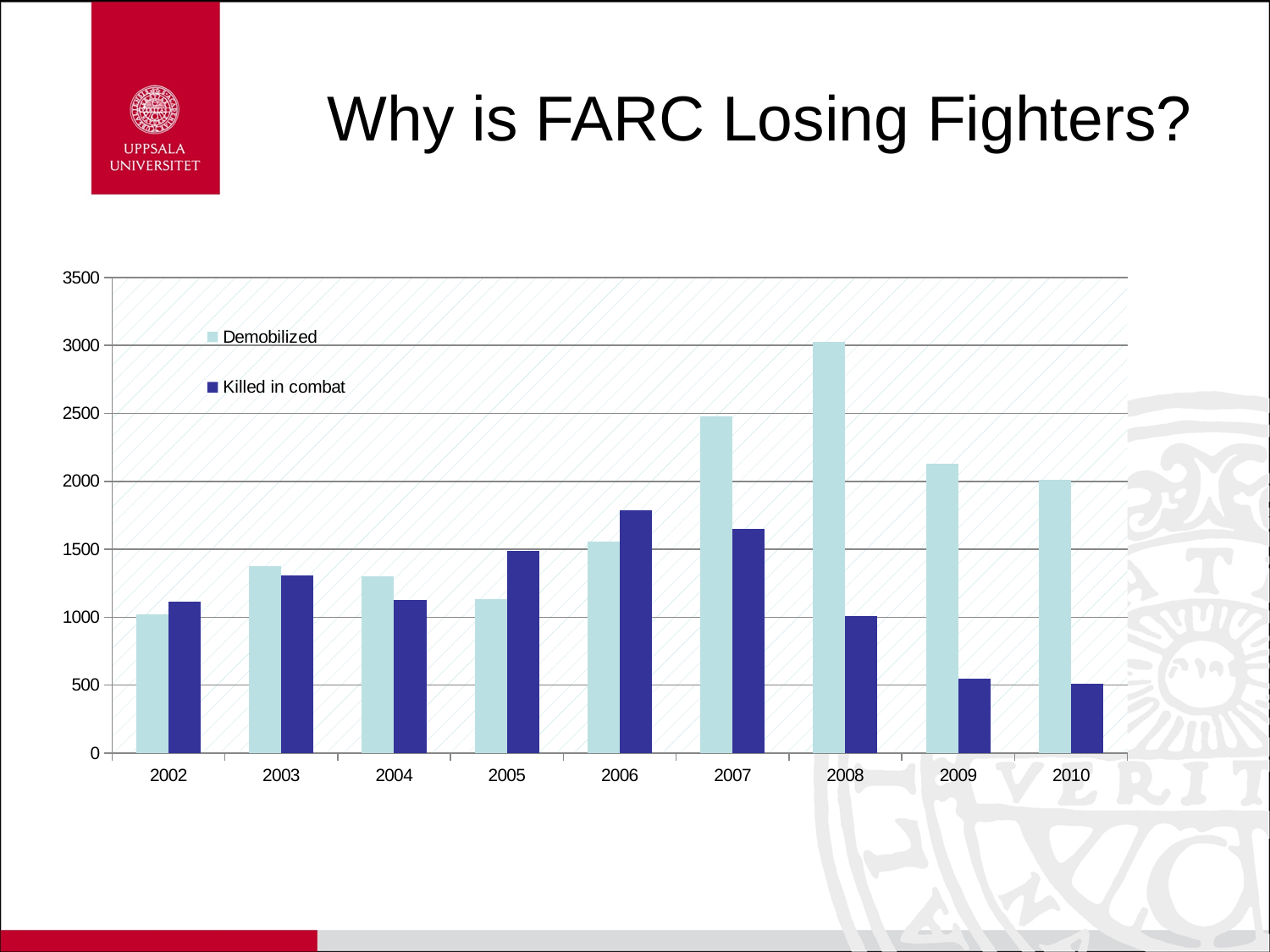
Is the Killed in combat value for 2009 greater or less than 1000? less Is the Demobilized value for 2010 greater or less than 1500? greater How many years are shown on the x axis? 9 Is the Killed in combat value for 2006 greater or less than 1500? greater In which year is the Killed in combat value highest? 2006 What kind of chart is shown on the slide? bar chart What is the title of the slide containing the chart? Why is FARC Losing Fighters? In 2005, which is larger: Demobilized or Killed in combat? Killed in combat How many series does the legend list? 2 In which year is the Demobilized value highest? 2008 In which year is the Demobilized value lowest? 2002 In 2008, which is larger: Demobilized or Killed in combat? Demobilized